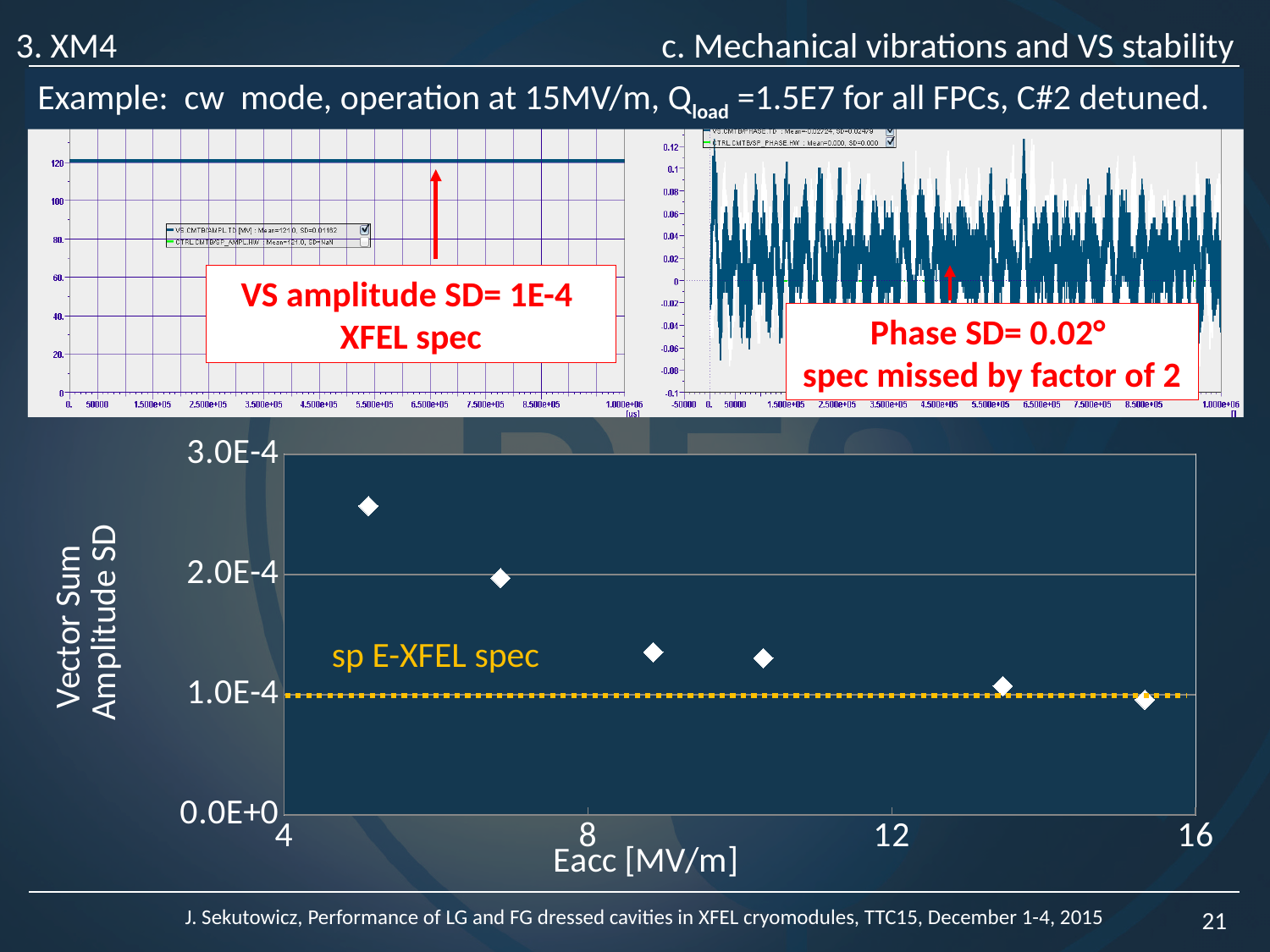
In the bottom chart, does the Vector Sum Amplitude SD rise or fall as Eacc increases? fall In the bottom chart, is the Vector Sum Amplitude SD for the point at the lowest Eacc (around 5 MV/m) greater or less than 2.0E-4? greater In the bottom chart, is the Vector Sum Amplitude SD for the point near Eacc = 9.5 MV/m greater or less than 1.0E-4? greater According to the annotation on the top-right phase plot, what is the phase SD? 0.02° In the bottom chart, how many data points are plotted? 6 In the bottom chart, what is the maximum value shown on the y axis? 3.0E-4 In the bottom chart, which point has the highest Vector Sum Amplitude SD: the one at the lowest Eacc or the one at the highest Eacc? the one at the lowest Eacc In the bottom chart, is the Vector Sum Amplitude SD for the point near Eacc = 11 MV/m greater or less than 2.0E-4? less In the bottom chart, at what Vector Sum Amplitude SD value is the dashed 'sp E-XFEL spec' line drawn? 1.0E-4 According to the annotation on the top-left amplitude plot, what is the VS amplitude SD XFEL spec? 1E-4 In the bottom chart, what is the label of the x axis? Eacc [MV/m] What kind of chart is the bottom chart of Vector Sum Amplitude SD versus Eacc? scatter chart